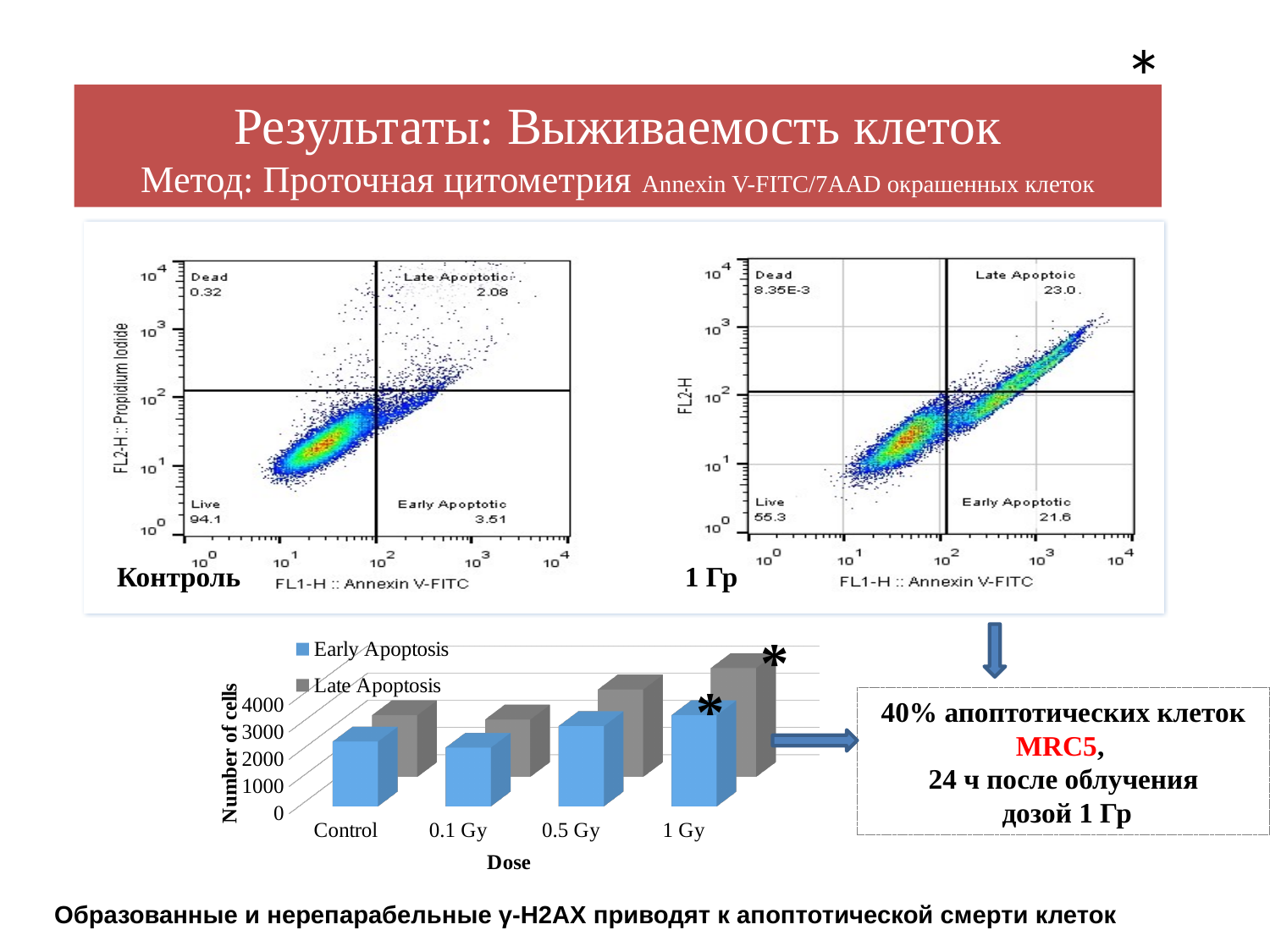
In the bar chart at the bottom of the slide, how many dose categories are shown on the x axis? 4 In the flow cytometry plot labelled Контроль, what percentage is shown in the Live quadrant? 94.1 In the bar chart at the bottom of the slide, which dose has the highest Late Apoptosis bar? 1 Gy In the bar chart at the bottom of the slide, what is the label of the vertical axis? Number of cells In the flow cytometry plot labelled 1 Гр, what value is shown in the Late Apoptoic quadrant? 23.0 What kind of chart is the chart at the bottom of the slide with the Dose axis? bar chart In the bar chart at the bottom of the slide, is the Early Apoptosis value for 1 Gy greater or less than 1000? greater In the bar chart at the bottom of the slide, is the Late Apoptosis value for 1 Gy greater or less than 3000? greater In the flow cytometry plot labelled 1 Гр, what value is shown in the Early Apoptotic quadrant? 21.6 In the bar chart at the bottom of the slide, do the Early Apoptosis values rise or fall as the dose increases from Control to 1 Gy? rise What is the difference between the Live quadrant value in the Контроль plot (94.1) and the Live quadrant value in the 1 Гр plot (55.3)? 38.8 In the bar chart at the bottom of the slide, how many series does the legend list? 2